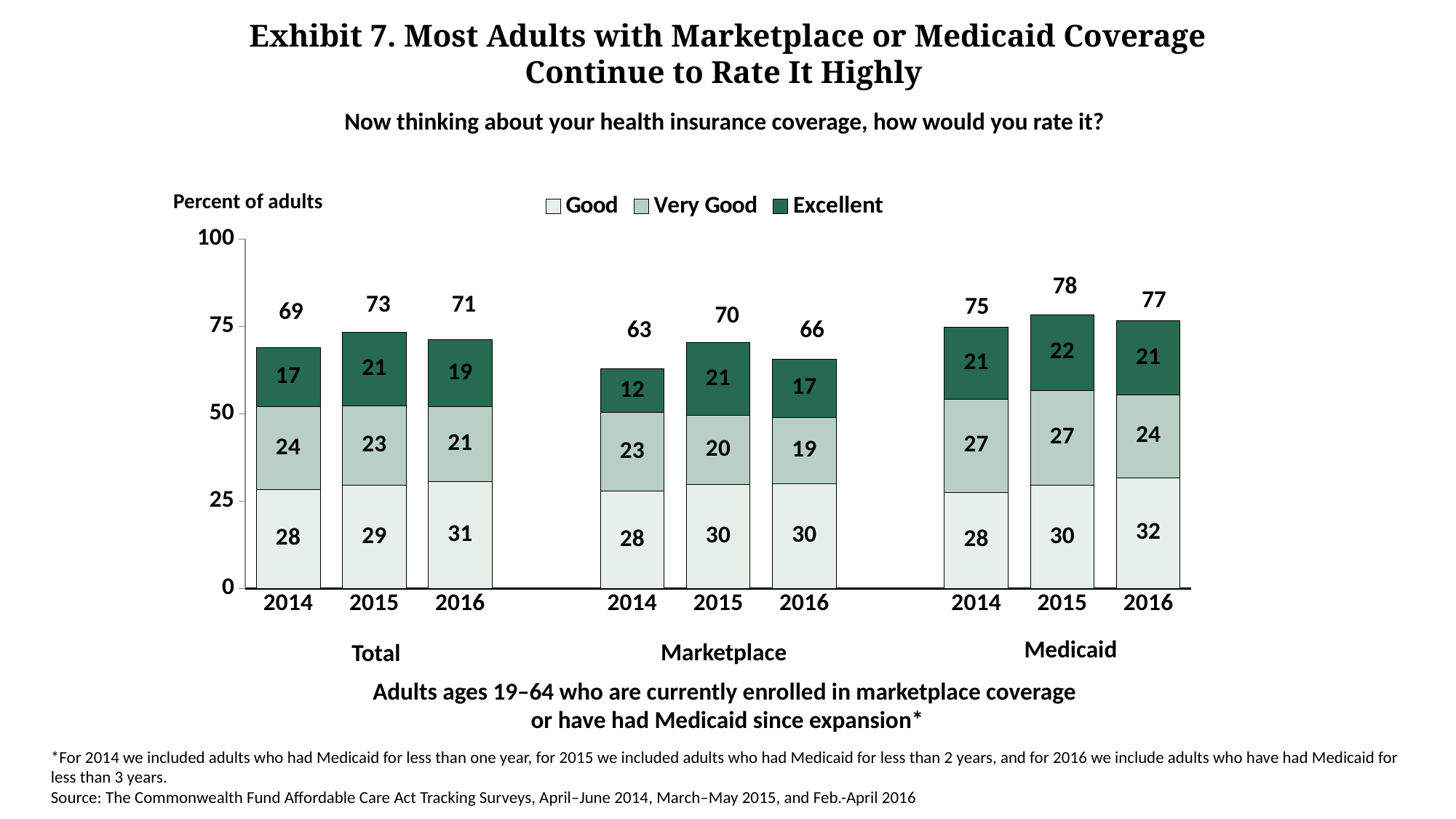
Which group and year has the highest stacked bar total? Medicaid 2015 What is the difference between the Excellent values for Marketplace in 2015 and 2014? 9 What is the Excellent value for Marketplace in 2014? 12 Which group and year has the lowest stacked bar total? Marketplace 2014 What kind of chart is shown? Stacked bar chart What is the Very Good value for Total in 2014? 24 What is the Good value for Medicaid in 2016? 32 What is the total of the stacked bar for Medicaid in 2014? 75 Do the stacked bar totals for Medicaid rise or fall from 2014 to 2015? Rise How many stacked bars are plotted on the chart? 9 How many series does the legend list? 3 Which is larger, the Very Good value for Medicaid in 2014 or for Marketplace in 2014? Medicaid 2014